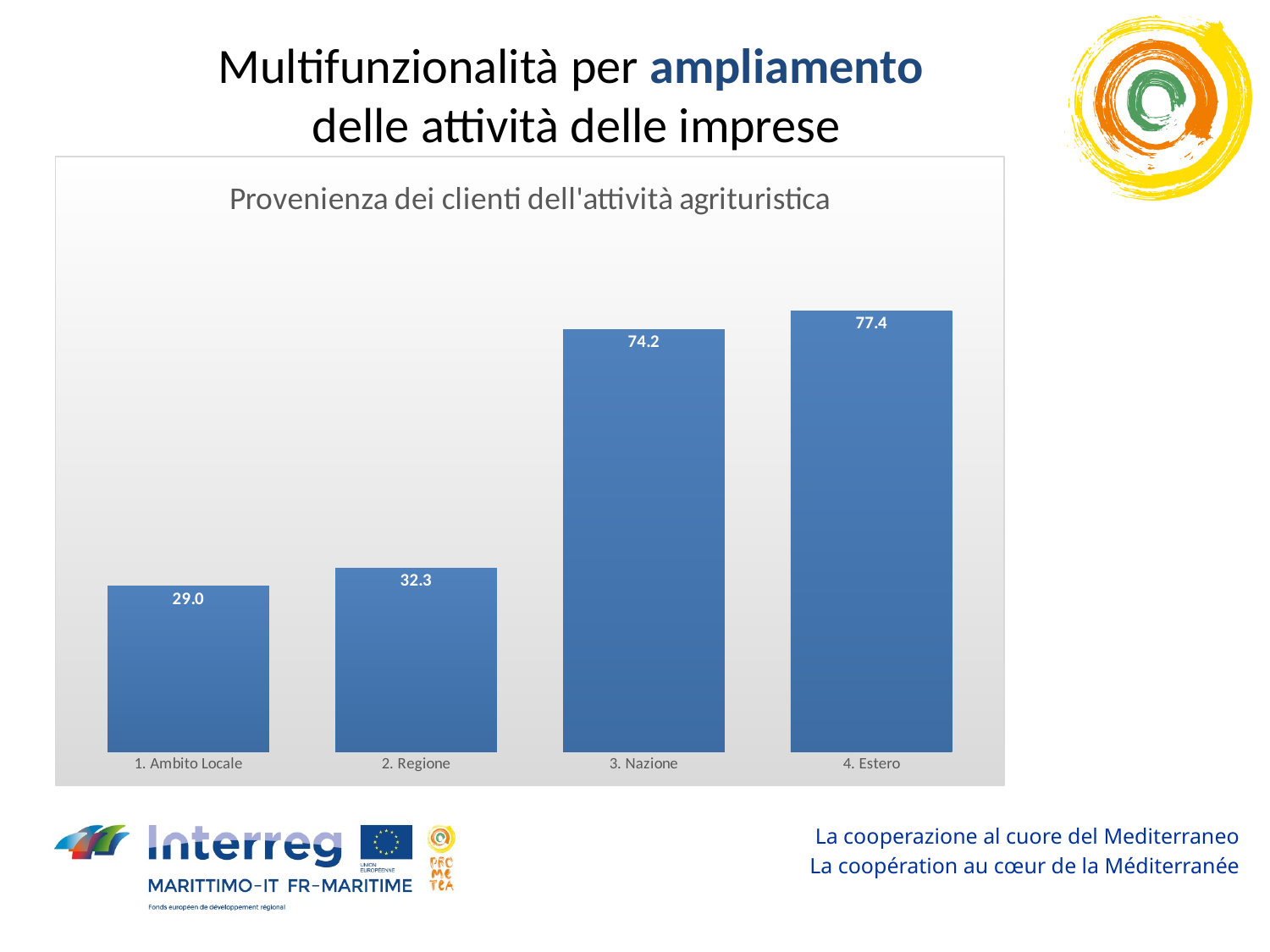
What is the title of the chart? Provenienza dei clienti dell'attività agrituristica Which category has the lowest value? 1. Ambito Locale What is the value for 2. Regione? 32.3 What is the value for 3. Nazione? 74.2 What kind of chart is shown on the slide? Bar chart What is the value for 4. Estero? 77.4 What is the value for 1. Ambito Locale? 29.0 Which is larger, the value for 2. Regione or the value for 3. Nazione? 3. Nazione Which category has the highest value? 4. Estero How many categories are shown in the chart? 4 What is the difference between the values for 2. Regione and 1. Ambito Locale? 3.3 What is the difference between the values for 4. Estero and 3. Nazione? 3.2